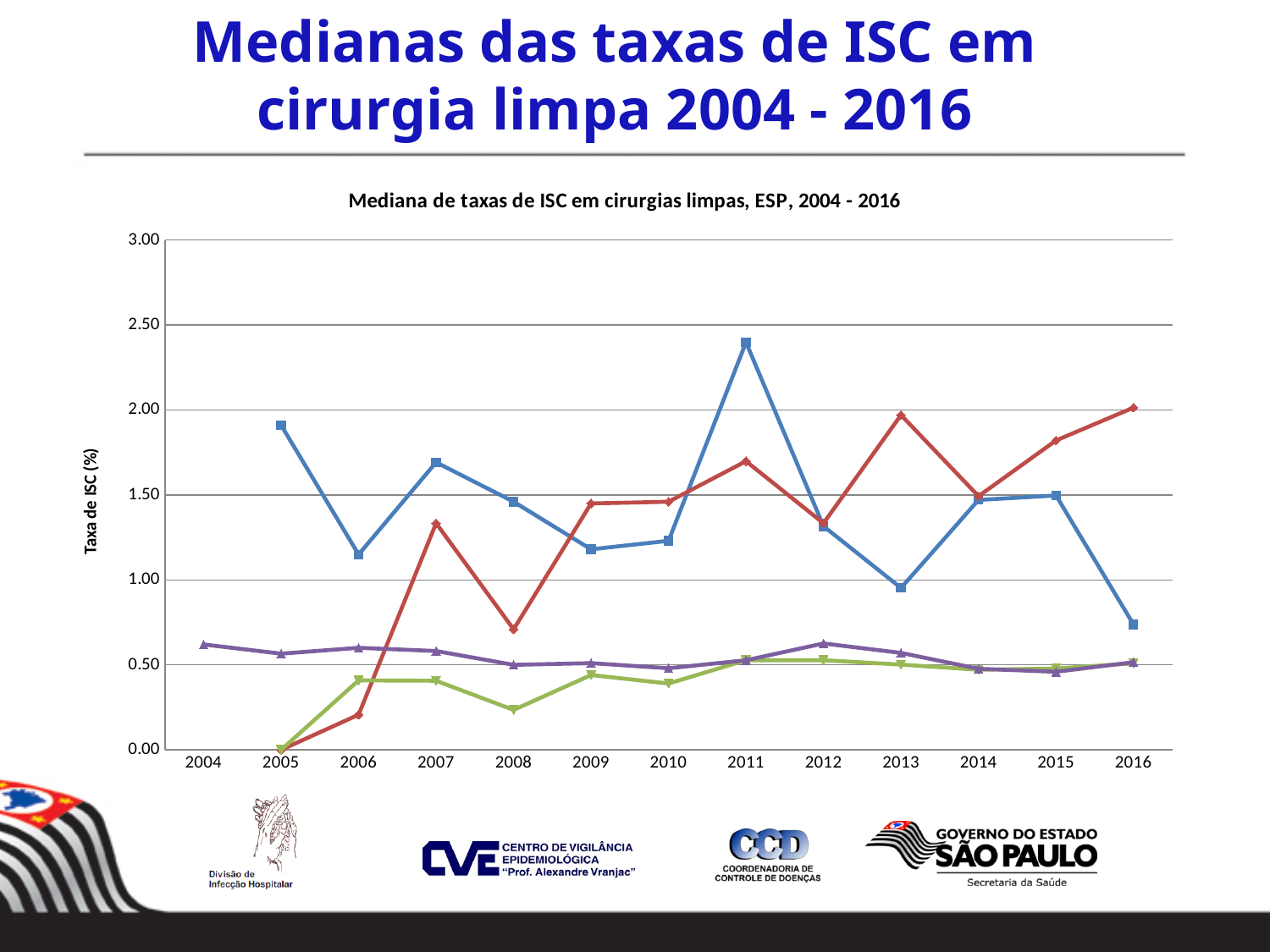
How many lines are plotted on the chart? 4 Is the value of the blue line in 2016 greater or less than 1.00? less How many years are shown along the x axis? 13 What is the title printed above the chart? Mediana de taxas de ISC em cirurgias limpas, ESP, 2004 - 2016 In which year does the blue line reach its lowest value? 2016 Does the red line rise or fall from 2014 to 2016? rise Is the value of the red line in 2008 greater or less than 1.00? less In which year does the blue line reach its highest value? 2011 Is the value of the blue line in 2011 greater or less than 2.00? greater What is the label of the vertical axis? Taxa de ISC (%) What kind of chart is shown on the slide? line chart In 2013, which line has the higher value, the red line or the blue line? red line